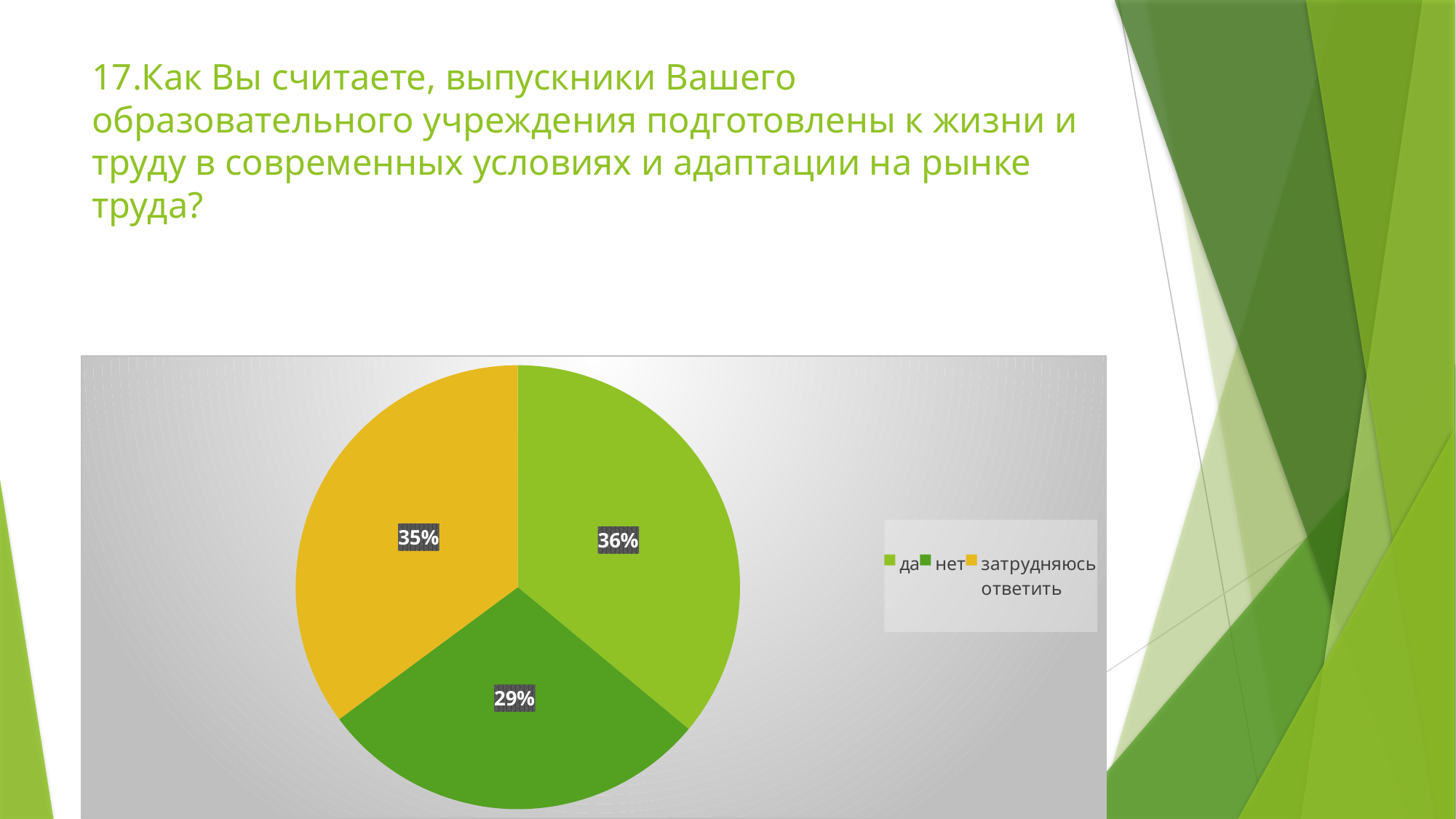
What kind of chart is shown on the slide? pie chart What is the difference in percentage points between the "затрудняюсь ответить" slice and the "нет" slice? 6 Which slice is larger, "нет" or "затрудняюсь ответить"? затрудняюсь ответить How many entries does the legend list? 3 Which answer option has the smallest slice of the pie? нет Which answer option has the largest slice of the pie? да How many slices does the pie chart have? 3 What colour is the "затрудняюсь ответить" slice in the pie chart? yellow What percentage of the pie is the "да" slice? 36% What percentage of the pie is the "затрудняюсь ответить" slice? 35% What percentage of the pie is the "нет" slice? 29% What is the difference in percentage points between the "да" slice and the "нет" slice? 7